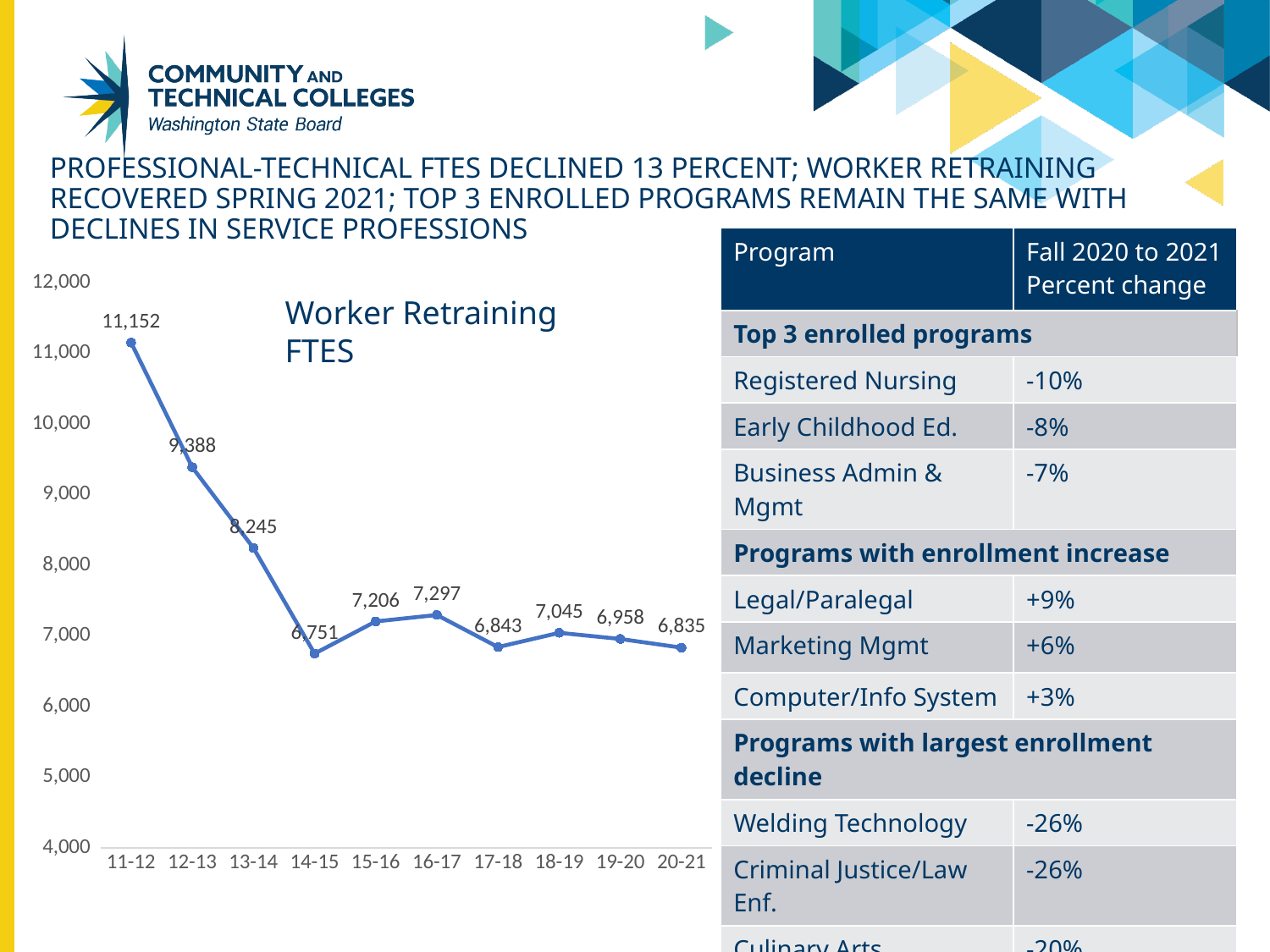
Which year has the highest Worker Retraining FTES? 11-12 What is the Worker Retraining FTES value for 16-17? 7,297 Which year has a higher Worker Retraining FTES value, 15-16 or 18-19? 15-16 How many years are plotted on the Worker Retraining FTES chart? 10 What is the difference in Worker Retraining FTES between 16-17 and 17-18? 454 Do Worker Retraining FTES values rise or fall from 11-12 to 14-15? fall Which year has the lowest Worker Retraining FTES? 14-15 What kind of chart is the Worker Retraining FTES chart? line chart What is the Worker Retraining FTES value for 11-12? 11,152 What is the Worker Retraining FTES value for 20-21? 6,835 Is the Worker Retraining FTES value for 13-14 greater or less than 8,000? greater What is the difference in Worker Retraining FTES between 11-12 and 12-13? 1,764